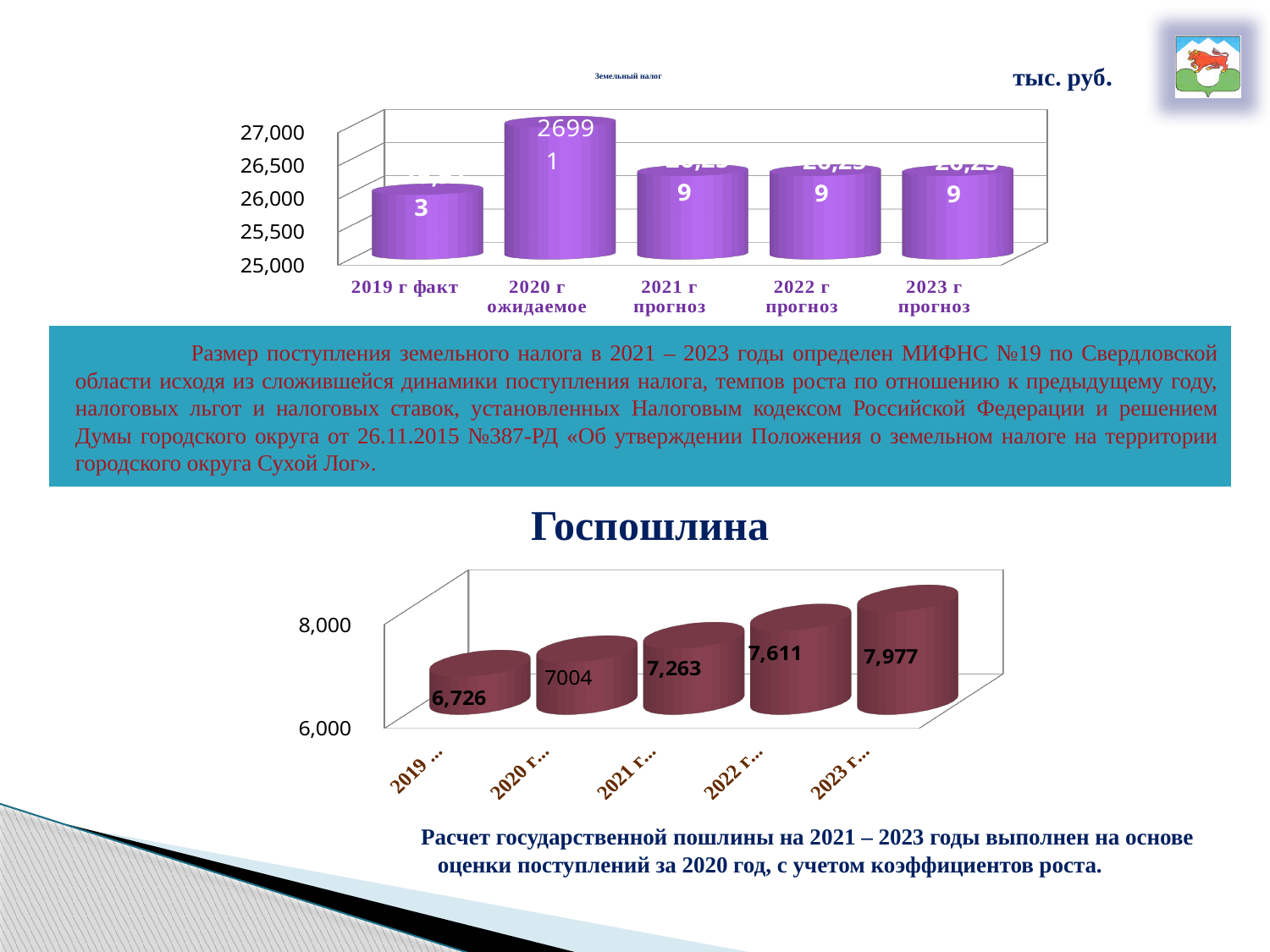
In the Госпошлина chart, do the values rise or fall from 2019 to 2023? rise In the Госпошлина chart, what is the value for 2019? 6,726 In the Земельный налог chart at the top, is the value for 2020 г ожидаемое greater or less than 26,500? greater In the Земельный налог chart at the top, which category has the highest value? 2020 г ожидаемое In the Госпошлина chart, is the value for 2022 greater or less than 8,000? less In the Госпошлина chart, what is the value for 2023? 7,977 In the Госпошлина chart, how many bars are plotted? 5 In the Госпошлина chart, what is the value for 2021? 7,263 In the Госпошлина chart, what is the difference between the values for 2023 and 2022? 366 In the Госпошлина chart, which year has the lowest value? 2019 What kind of chart is the Госпошлина chart? bar chart In the Госпошлина chart, which year has the highest value? 2023